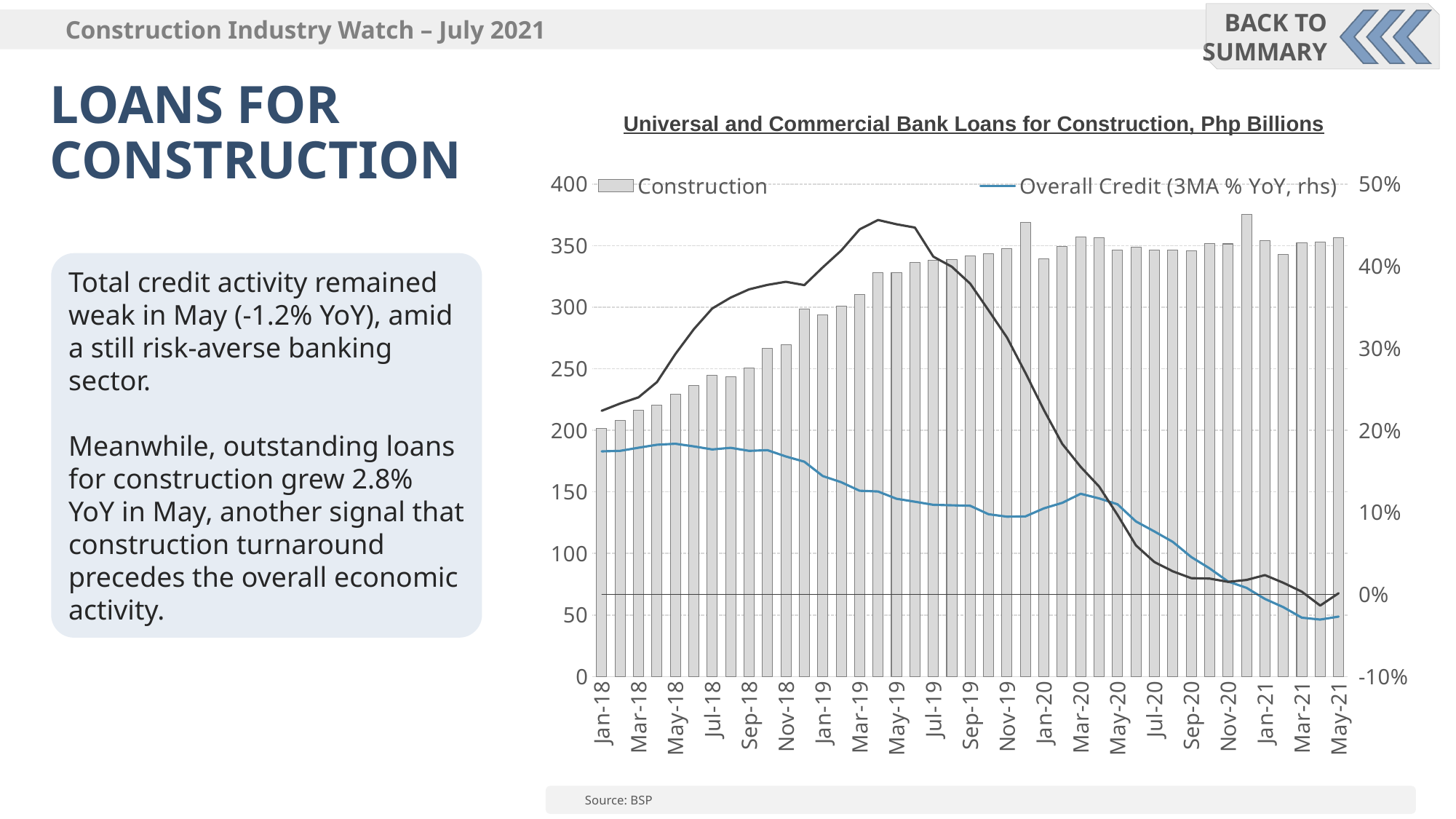
What is the title of the chart? Universal and Commercial Bank Loans for Construction, Php Billions Is the Construction bar for Jan-20 greater or less than 300? greater Is the Construction bar for Nov-18 greater or less than 250? greater Is the Construction bar for May-21 greater or less than 300? greater How many series does the chart legend list? 2 What kind of chart is shown on the slide? A bar chart combined with a line chart Which month has the lowest Construction bar? Jan-18 What are the two series named in the legend? Construction; Overall Credit (3MA % YoY, rhs) Does the Overall Credit (3MA % YoY, rhs) line generally rise or fall from Jan-18 to May-21? fall